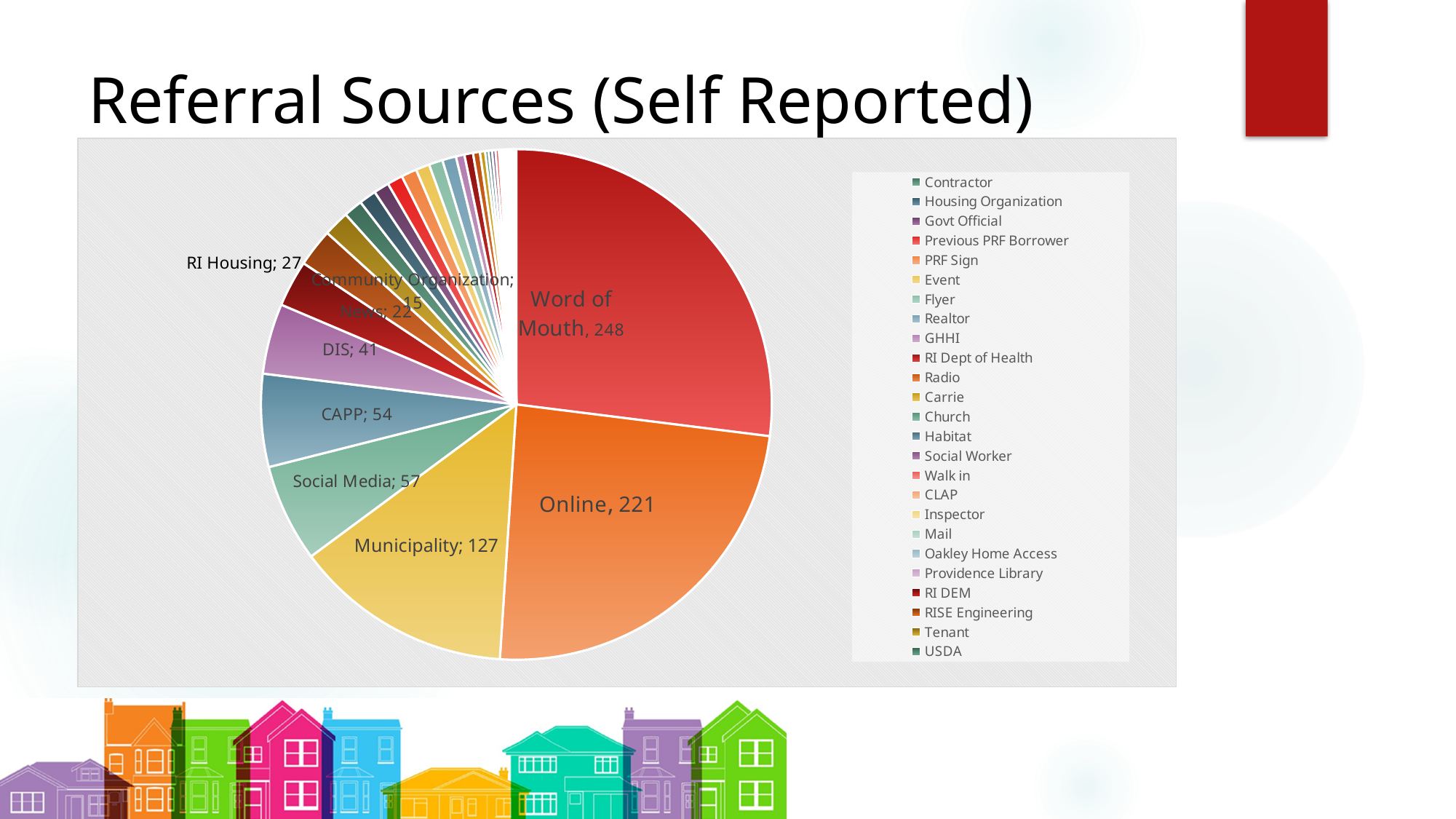
What is the difference between the Word of Mouth value and the Online value? 27 What is the value shown for News? 22 What is the value shown for Online? 221 What is the value shown for DIS? 41 What is the value shown for Municipality? 127 What is the value shown for Social Media? 57 What is the title of the slide containing the chart? Referral Sources (Self Reported) What kind of chart is shown on the slide? pie chart What is the value shown for RI Housing? 27 How many entries are listed in the legend on the right of the chart? 25 Which referral source has the largest slice of the pie? Word of Mouth Which is larger, the value for CAPP or the value for Social Media? Social Media